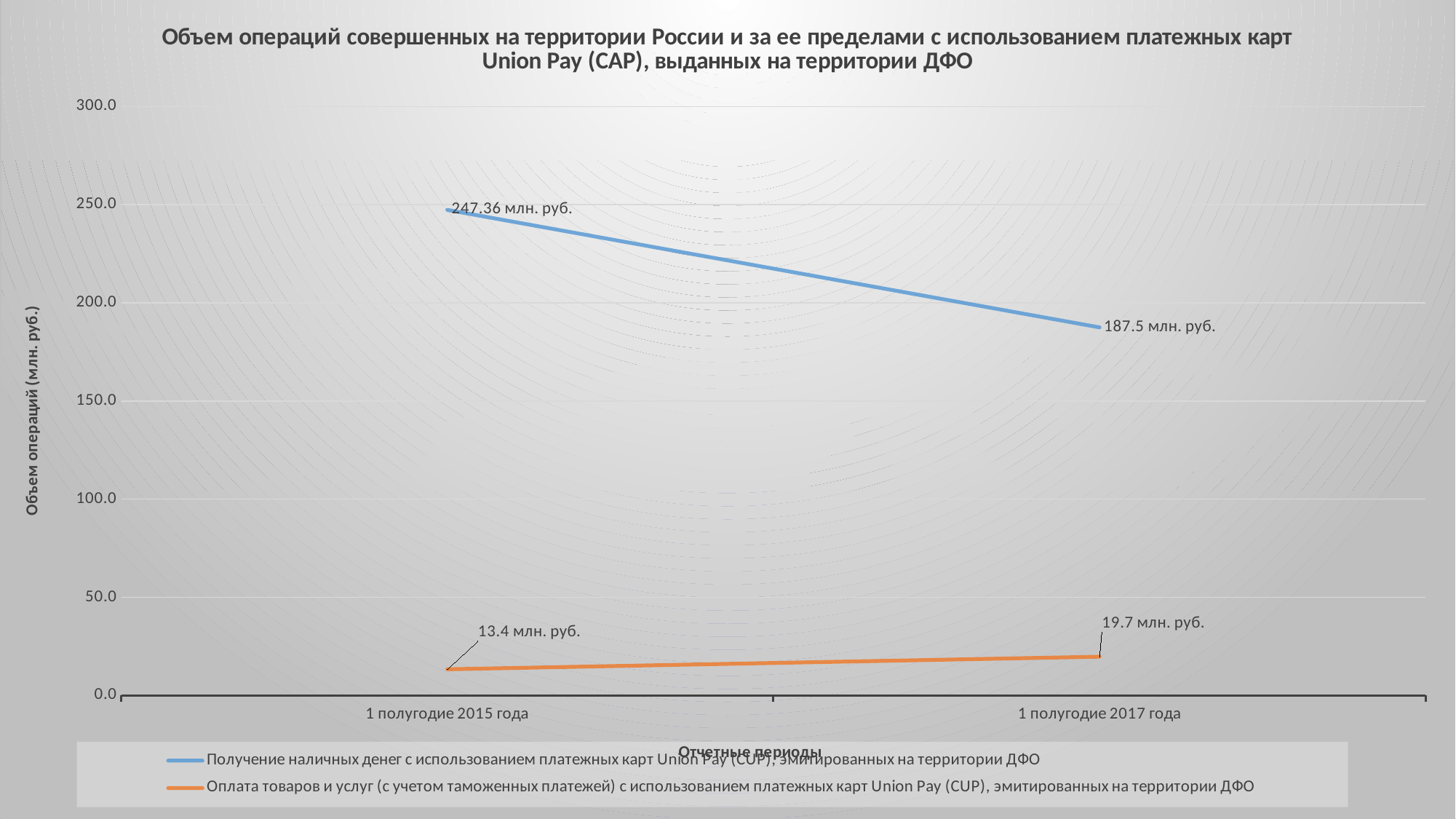
How many series does the legend list? 2 Does the payment for goods and services series (orange line) rise or fall from 1 полугодие 2015 года to 1 полугодие 2017 года? rise What colour is the line for payment for goods and services (Оплата товаров и услуг)? orange Which series has the higher value in 1 полугодие 2017 года: cash withdrawals or payment for goods and services? cash withdrawals (Получение наличных денег) How many reporting periods are shown on the x axis? 2 What type of chart is shown on the slide? line chart What is the value for cash withdrawals (Получение наличных денег) in 1 полугодие 2015 года? 247.36 млн. руб. What is the value for cash withdrawals (Получение наличных денег) in 1 полугодие 2017 года? 187.5 млн. руб. What is the value for payment for goods and services (Оплата товаров и услуг) in 1 полугодие 2017 года? 19.7 млн. руб. What is the value for payment for goods and services (Оплата товаров и услуг) in 1 полугодие 2015 года? 13.4 млн. руб. By how much did the cash withdrawal value decrease from 1 полугодие 2015 года to 1 полугодие 2017 года? 59.86 млн. руб. Does the cash withdrawal series (blue line) rise or fall from 1 полугодие 2015 года to 1 полугодие 2017 года? fall